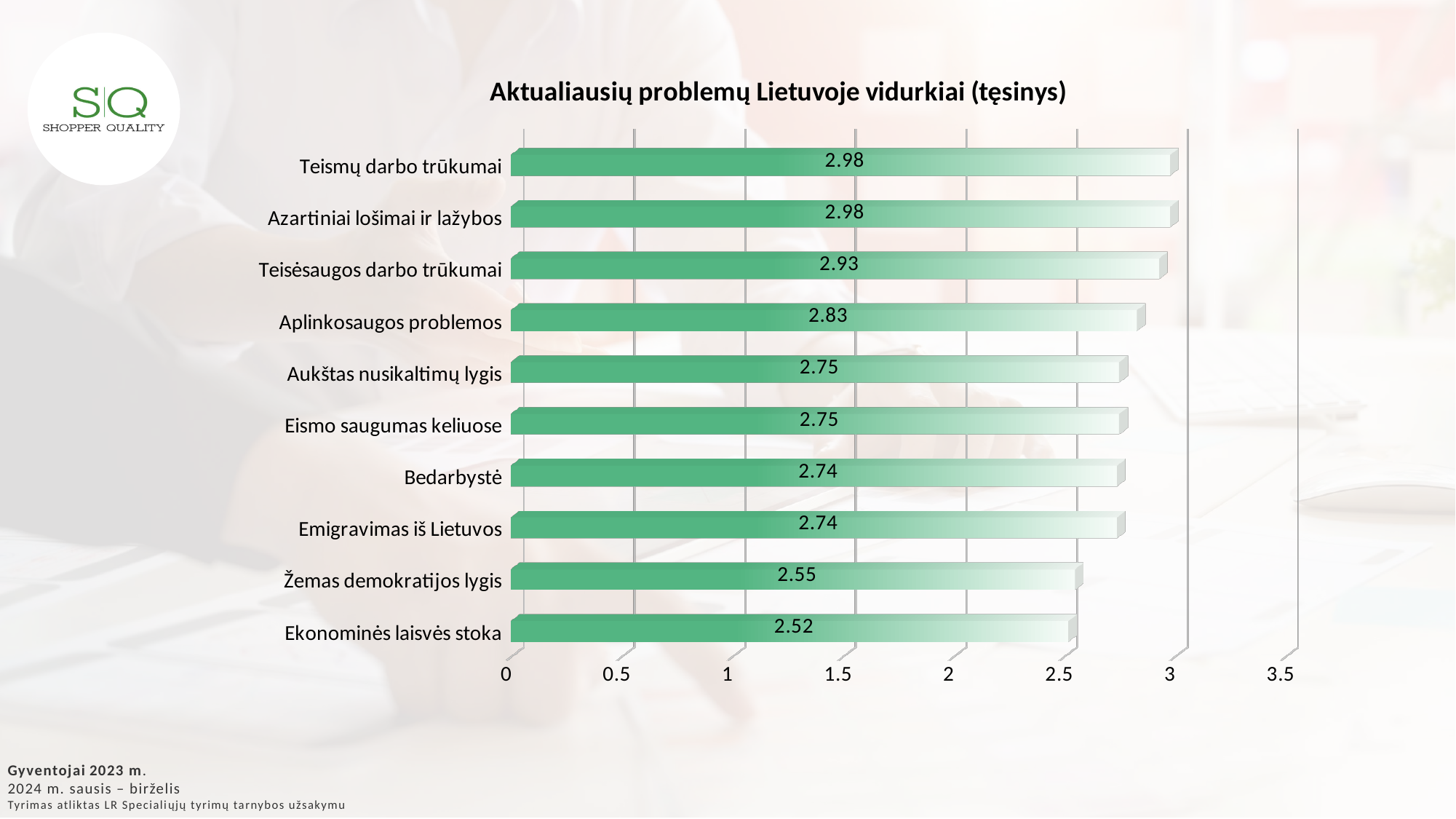
What is the value for Bedarbystė? 2.74 What is the value for Teisėsaugos darbo trūkumai? 2.93 What is the value for Aplinkosaugos problemos? 2.83 What is the difference between the values for Teisėsaugos darbo trūkumai and Aplinkosaugos problemos? 0.1 Is the value for Azartiniai lošimai ir lažybos greater or less than 2.5? greater How many categories are shown in the chart? 10 What kind of chart is shown on the slide? bar chart Which is larger, the value for Aplinkosaugos problemos or the value for Žemas demokratijos lygis? Aplinkosaugos problemos What is the difference between the values for Teismų darbo trūkumai and Ekonominės laisvės stoka? 0.46 What is the title of the chart? Aktualiausių problemų Lietuvoje vidurkiai (tęsinys) What is the value for Žemas demokratijos lygis? 2.55 Which category has the lowest value? Ekonominės laisvės stoka